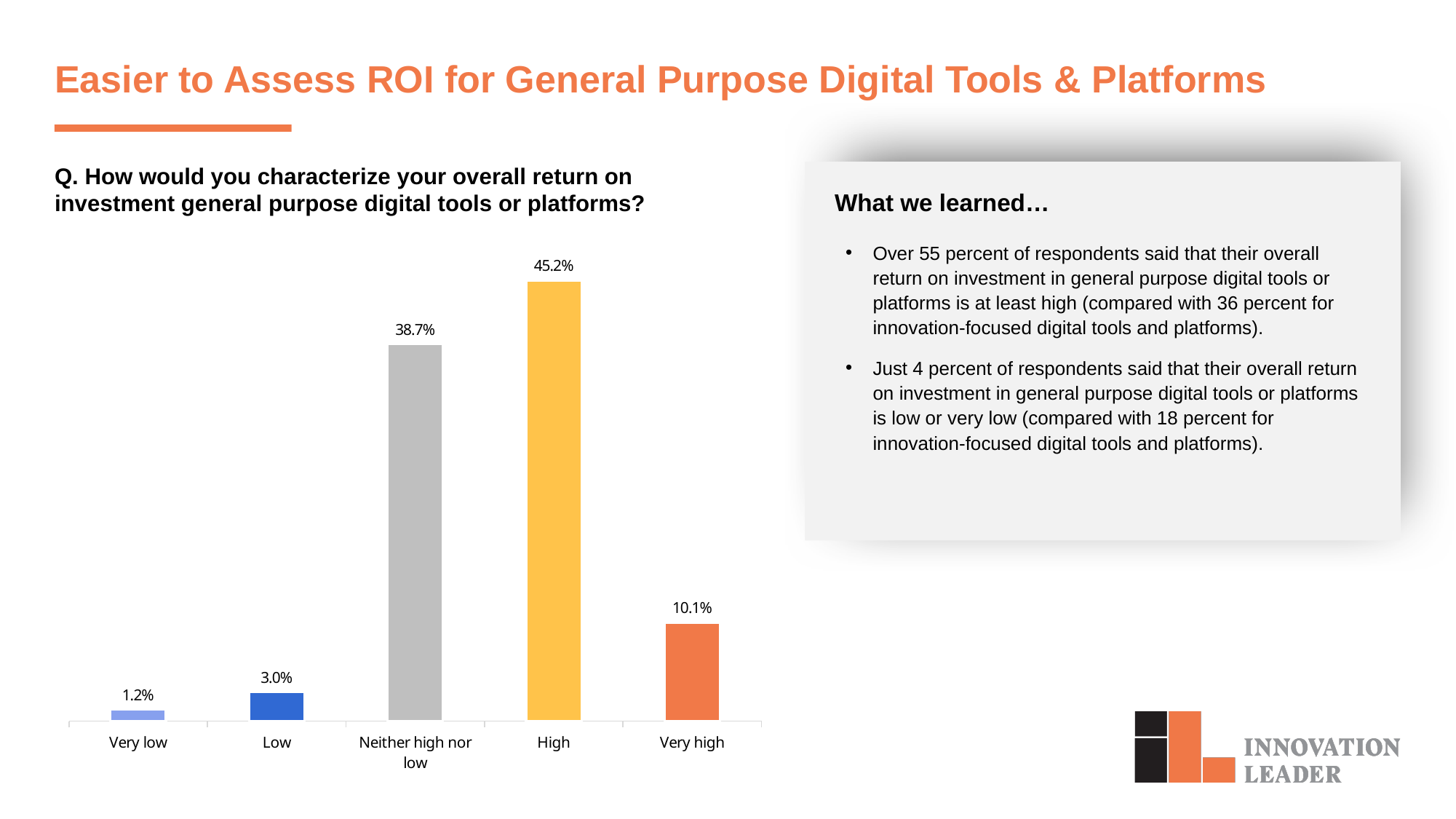
What kind of chart is shown on the slide? Bar chart What is the combined value of the Very low and Low categories? 4.2% What is the value shown for the Very high category? 10.1% Which is larger, the value for Low or the value for Very high? Very high What is the difference between the High and Neither high nor low values? 6.5% What is the difference between the Very high and Low values? 7.1% How many categories are shown on the x axis of the chart? 5 Which category has the highest value? High What percentage of respondents characterized their ROI as High? 45.2% What percentage of respondents characterized their ROI as Very low? 1.2% What is the value shown for the Neither high nor low category? 38.7% Which category has the lowest value? Very low